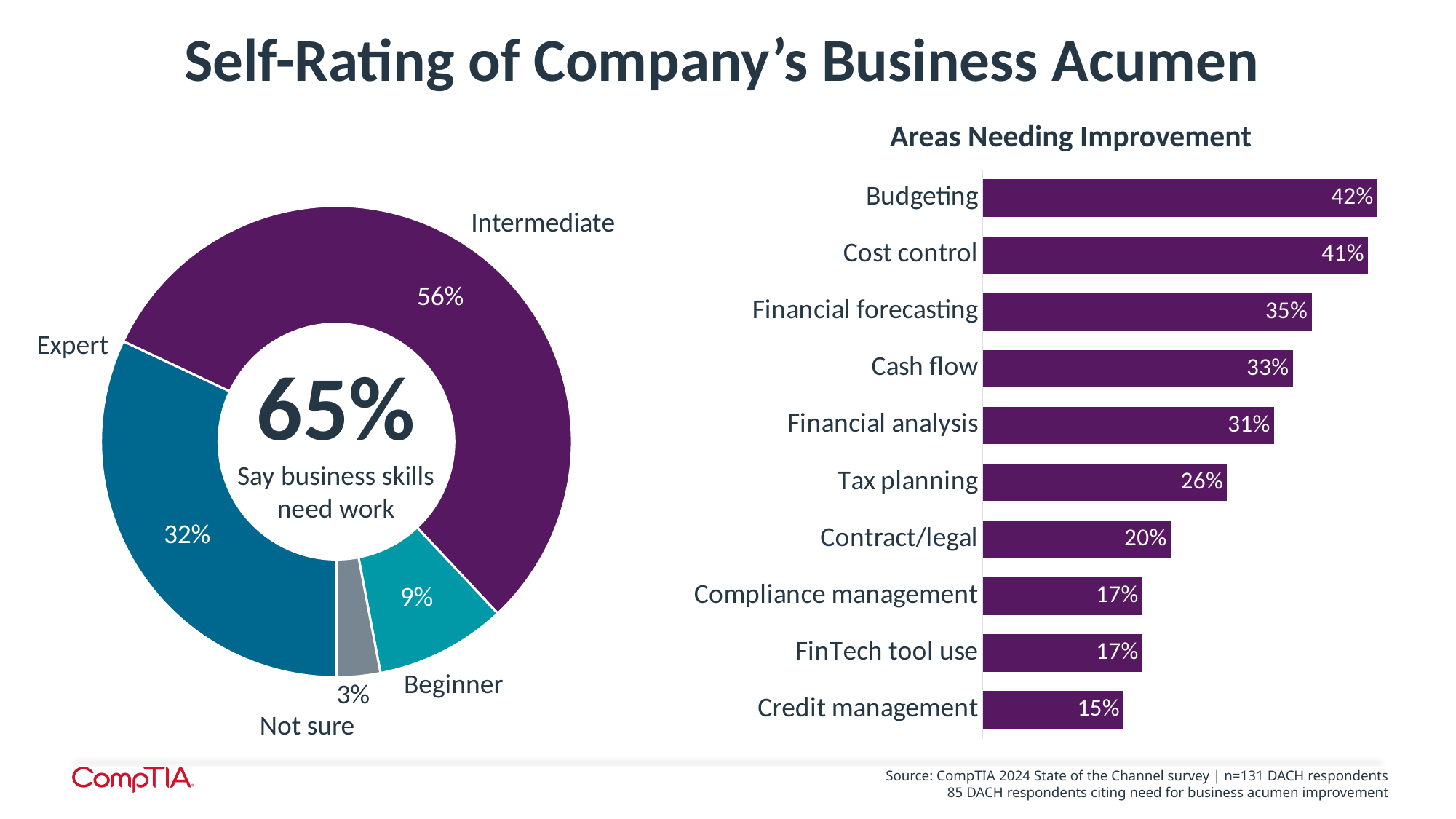
In the Areas Needing Improvement chart, which area has the lowest value? Credit management In the donut chart on the left, what percentage of respondents rated their company as Expert? 32% What type of chart is the Areas Needing Improvement chart? Bar chart In the donut chart on the left, what is the difference between the Intermediate and Expert shares? 24 percentage points In the Areas Needing Improvement chart, what is the value for Cash flow? 33% In the donut chart on the left, which category has the smallest share? Not sure In the Areas Needing Improvement chart, which is larger: Financial forecasting or Contract/legal? Financial forecasting In the donut chart on the left, how many categories are shown? 4 In the Areas Needing Improvement chart, which area has the highest value? Budgeting In the donut chart on the left, what percentage of respondents rated their company's business acumen as Intermediate? 56% In the Areas Needing Improvement chart, how many areas are listed? 10 In the Areas Needing Improvement chart, what is the difference between Budgeting and Tax planning? 16 percentage points